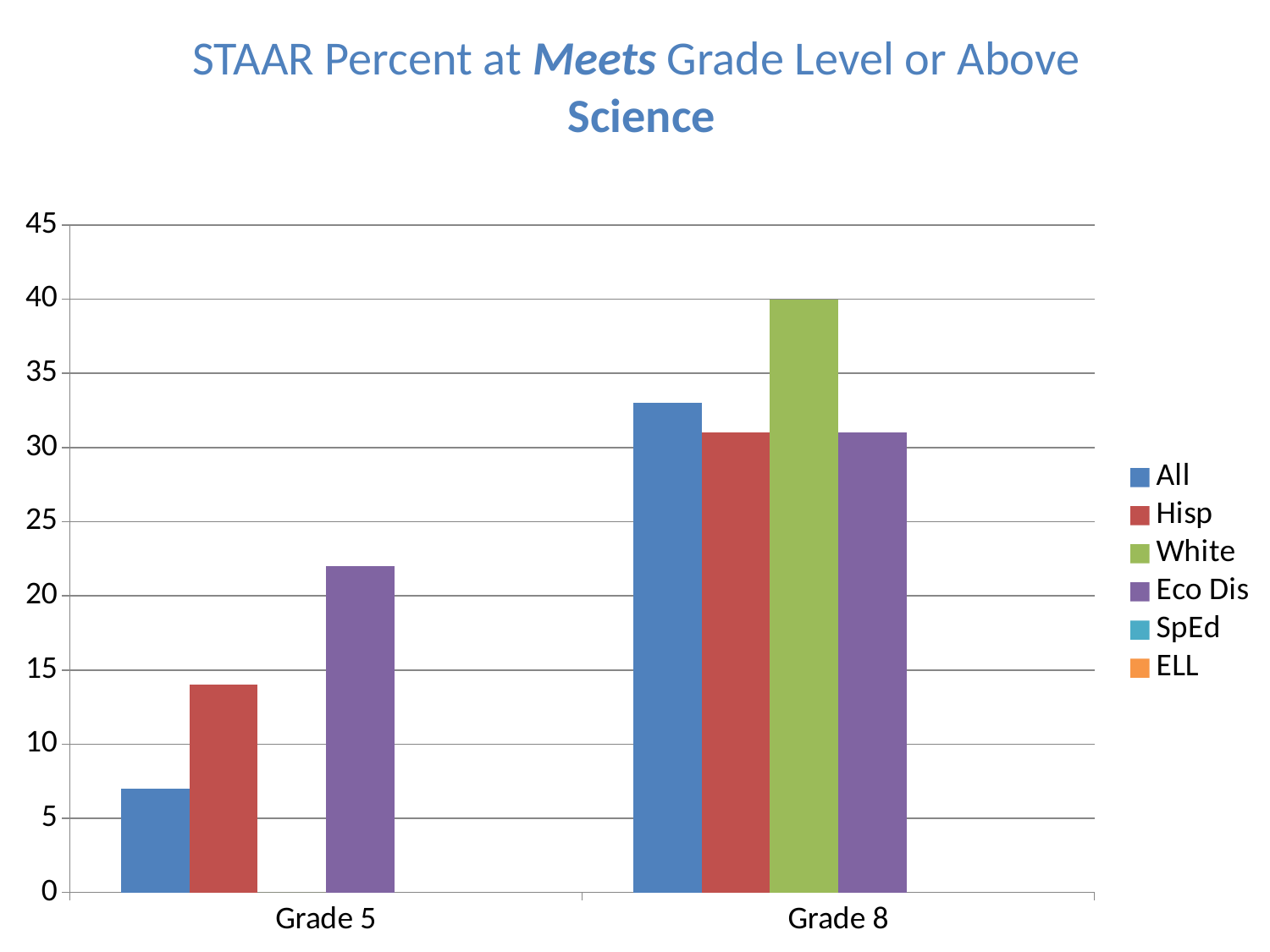
Is the value for All in Grade 8 greater or less than 30? greater Is the value for All in Grade 5 greater or less than 10? less Which series has the highest value in Grade 5? Eco Dis Which subject is named in the chart title? Science Which series has the highest value in Grade 8? White Which is larger, the value for Hisp in Grade 5 or the value for Hisp in Grade 8? Grade 8 What kind of chart is shown on the slide? bar chart What is the value for White in Grade 8? 40 Is the value for Eco Dis in Grade 5 greater or less than 20? greater How many grade categories are shown on the x axis? 2 How many series does the legend list? 6